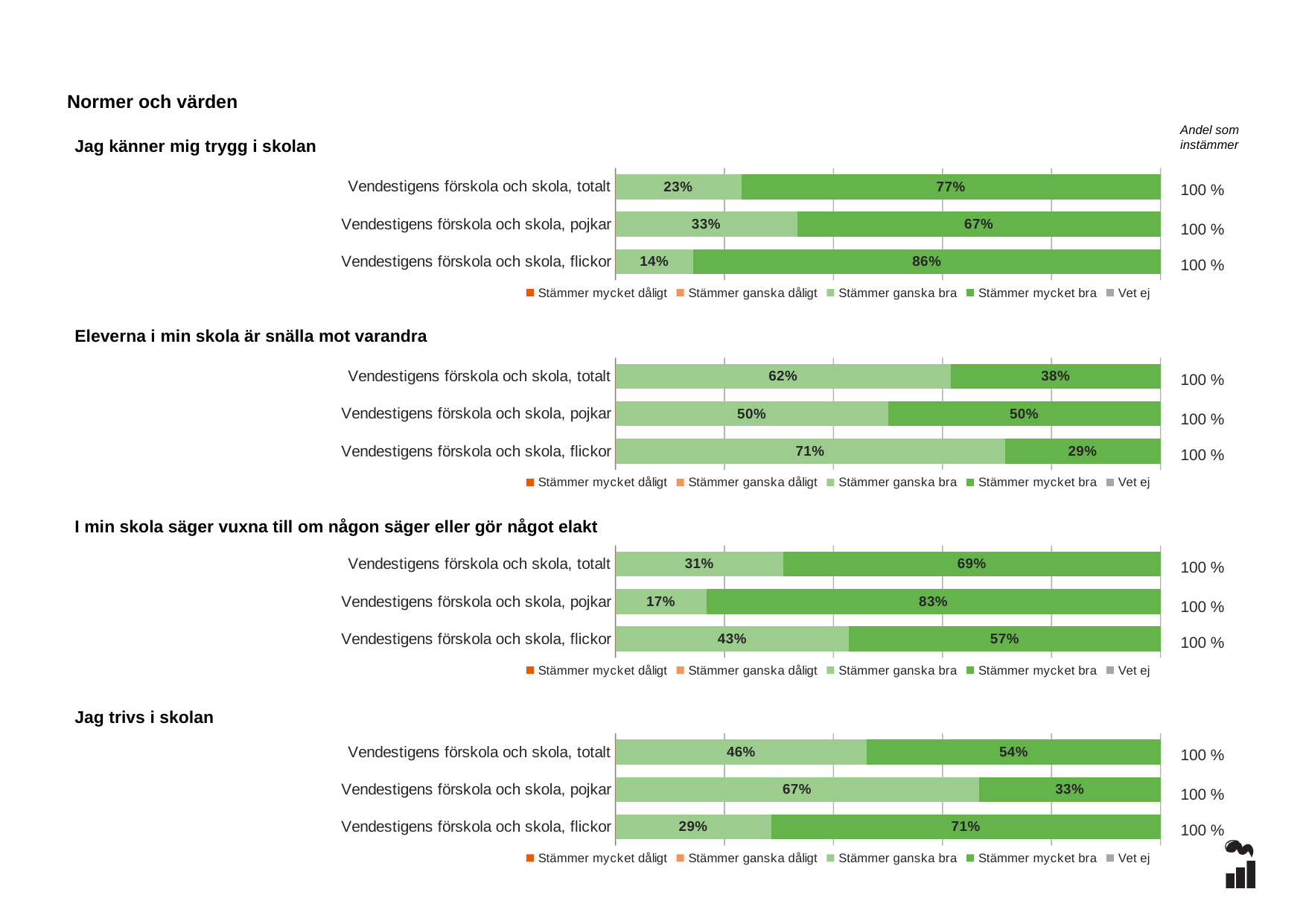
How many categories are shown in the chart 'Eleverna i min skola är snälla mot varandra'? 3 In the chart 'Jag trivs i skolan', what is the value of 'Stämmer mycket bra' for 'Vendestigens förskola och skola, flickor'? 71% In the chart 'Jag känner mig trygg i skolan', what is the value of 'Stämmer ganska bra' for 'Vendestigens förskola och skola, pojkar'? 33% In the chart 'Jag trivs i skolan', what is the total of the stacked bar for 'Vendestigens förskola och skola, totalt'? 100% In the chart 'I min skola säger vuxna till om någon säger eller gör något elakt', which category has the lowest 'Stämmer ganska bra' value? Vendestigens förskola och skola, pojkar In the chart 'Eleverna i min skola är snälla mot varandra', what is the value of 'Stämmer mycket bra' for 'Vendestigens förskola och skola, totalt'? 38% In the chart 'Eleverna i min skola är snälla mot varandra', which category has the highest 'Stämmer ganska bra' value? Vendestigens förskola och skola, flickor In the chart 'Jag trivs i skolan', which is larger for 'Vendestigens förskola och skola, pojkar': 'Stämmer ganska bra' or 'Stämmer mycket bra'? Stämmer ganska bra What kind of chart is 'Jag trivs i skolan'? Stacked bar chart How many series does the legend list for the chart 'Jag känner mig trygg i skolan'? 5 In the chart 'I min skola säger vuxna till om någon säger eller gör något elakt', what is the difference between the 'Stämmer mycket bra' values for pojkar and flickor? 26% In the chart 'Jag känner mig trygg i skolan', what is the value of 'Stämmer mycket bra' for 'Vendestigens förskola och skola, flickor'? 86%